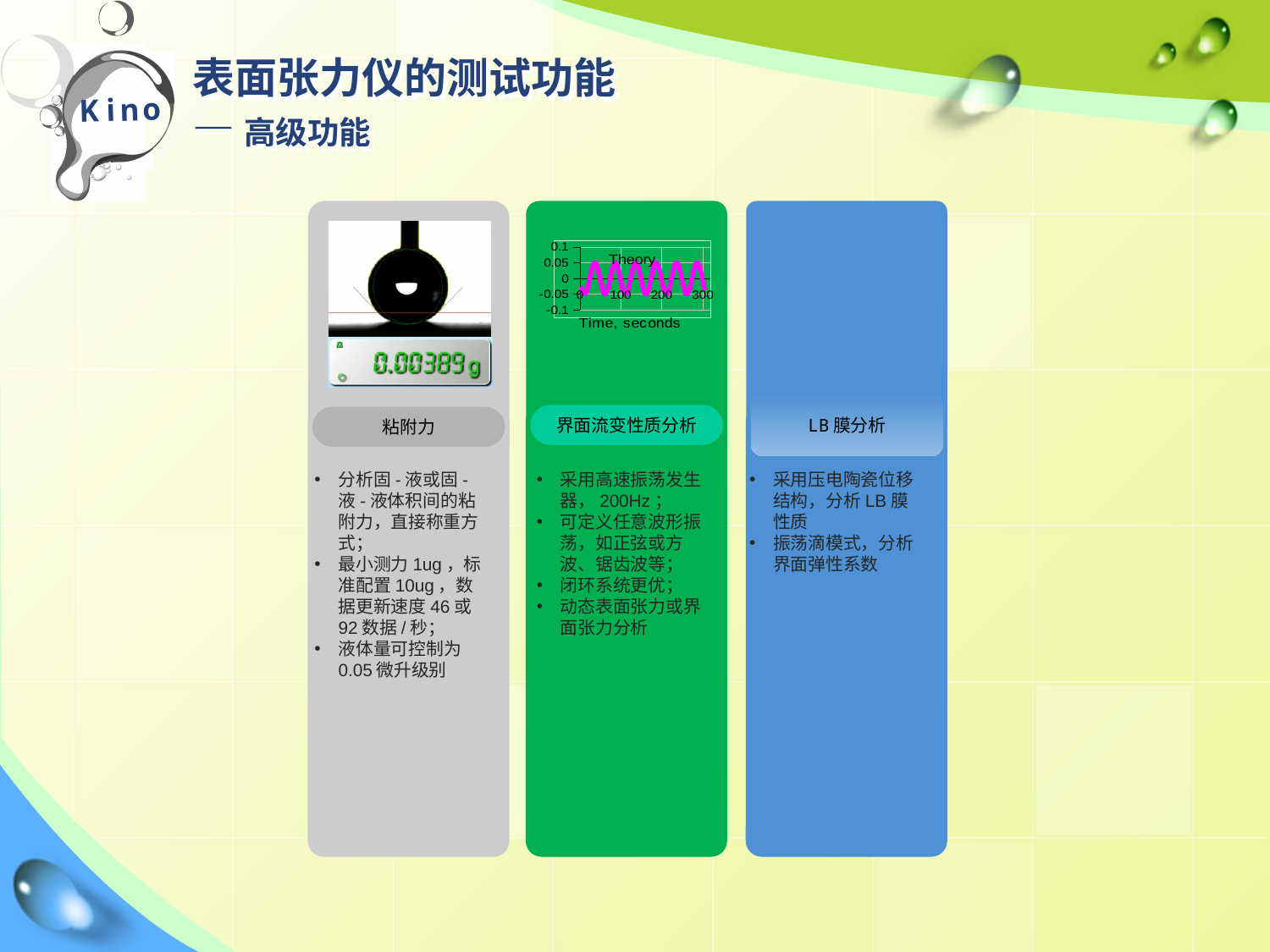
What is the x-axis title of the chart in the middle panel? Time, seconds What is the largest tick value shown on the x-axis of the chart in the middle panel? 300 What is the highest tick value shown on the y-axis of the chart in the middle panel? 0.1 What is the name of the series shown in the legend of the chart in the middle panel? Theory What is the lowest tick value shown on the y-axis of the chart in the middle panel? -0.1 How many series does the legend of the chart in the middle panel list? 1 What kind of chart is shown in the middle green panel? line chart